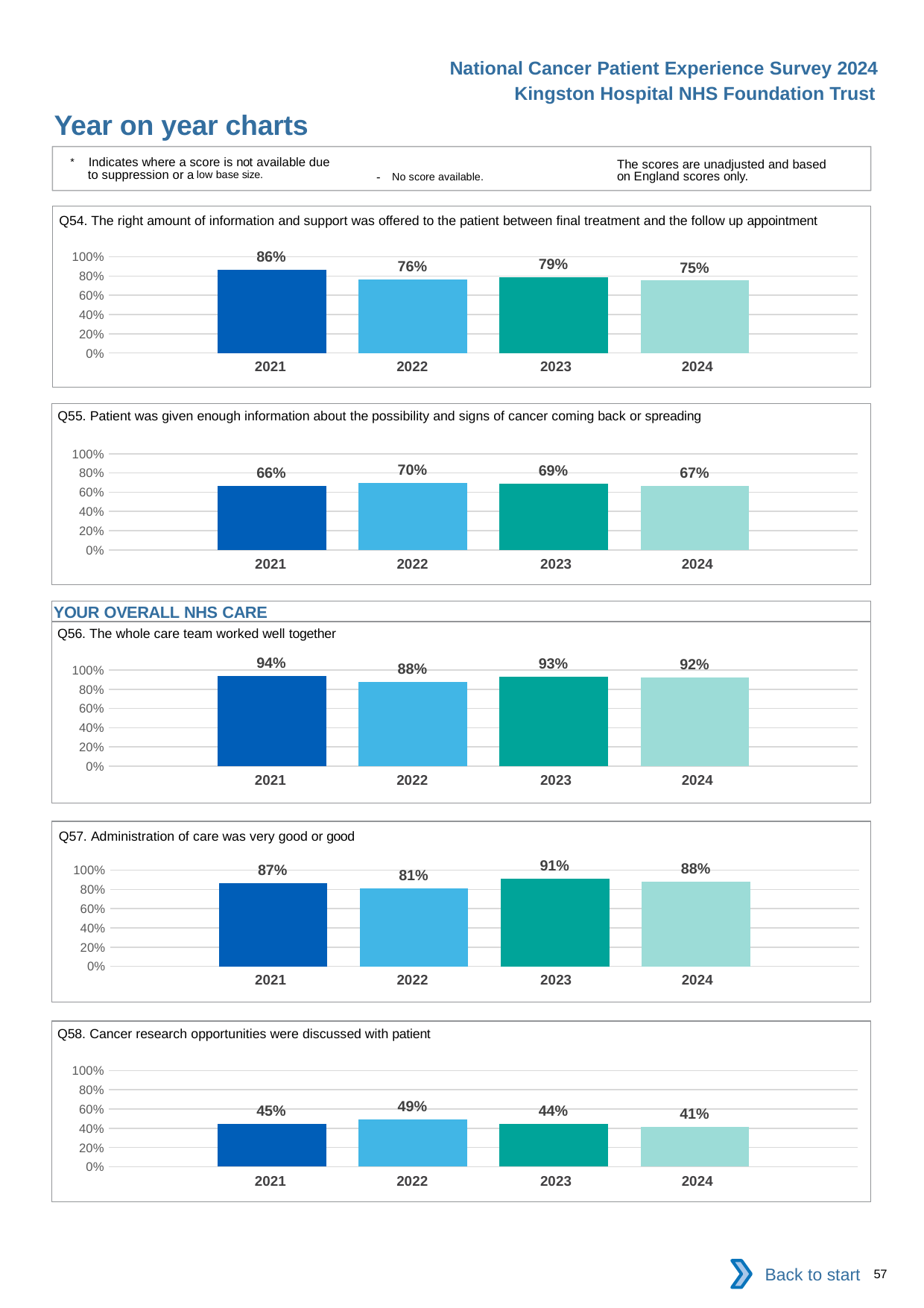
In the Q58 chart, what is the value for 2024? 41% How many years are shown in the Q58 chart? 4 In the Q55 chart, what is the value for 2022? 70% In the Q57 chart, what is the difference between the 2023 and 2022 values? 10 percentage points In the Q57 chart, which is larger, the value for 2023 or the value for 2022? 2023 In the Q56 chart, what is the value for 2024? 92% In the Q56 chart, which year has the highest value? 2021 In the Q58 chart, is the value for 2022 greater or less than 60%? less In the Q54 chart, which year has the lowest value? 2024 What kind of chart is the Q54 chart? bar chart In the Q55 chart, what is the difference between the 2022 and 2021 values? 4 percentage points In the Q54 chart, what is the value for 2021? 86%